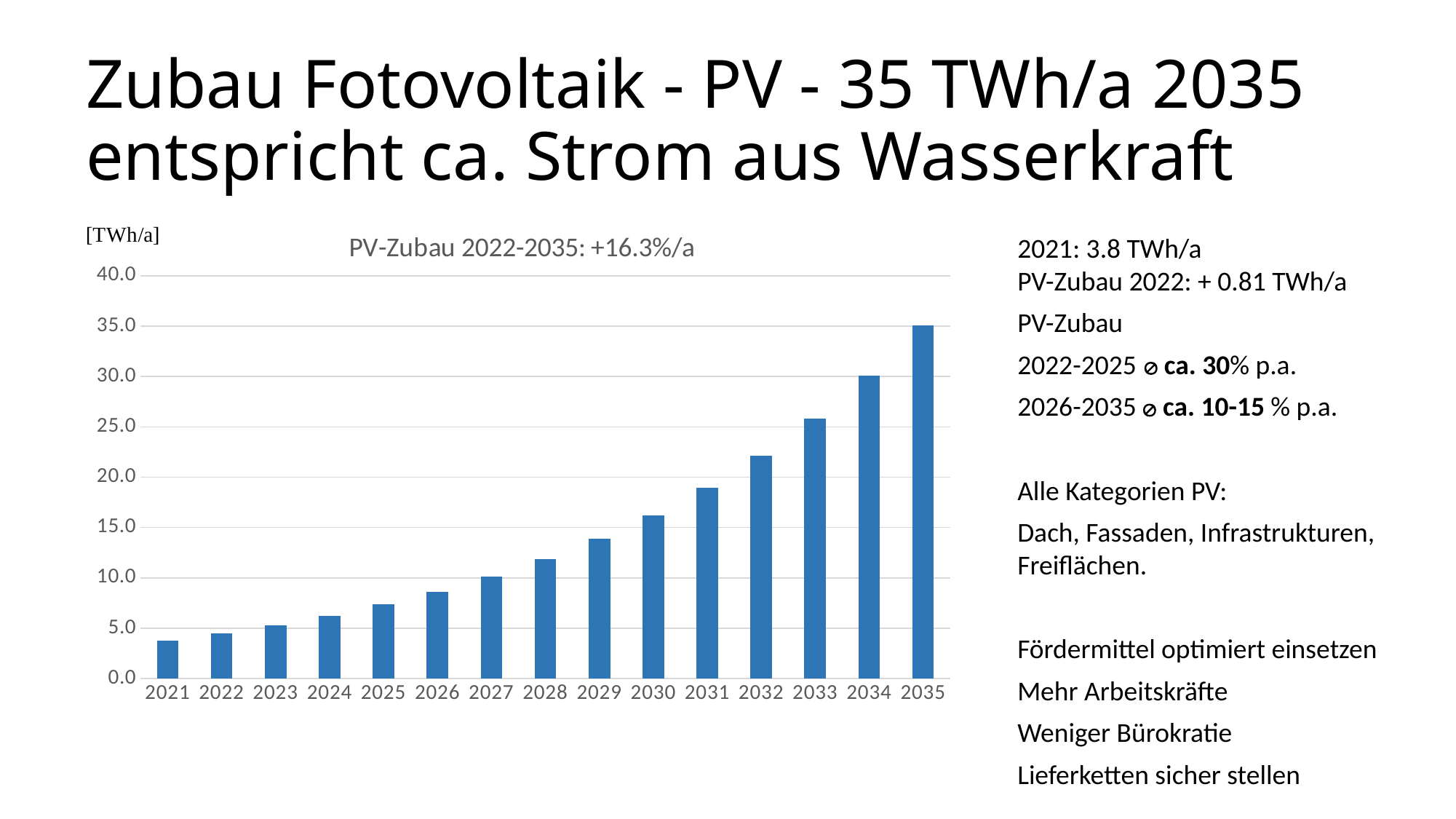
Which year has the lowest bar in the chart? 2021 Which year has the highest bar in the chart? 2035 What unit is shown on the y axis of the chart? [TWh/a] Do the values rise or fall from 2021 to 2035? rise Which is larger, the value for 2032 or the value for 2029? 2032 What kind of chart is shown on the slide? bar chart What is the value for 2035 in the chart? 35.0 Is the value for 2022 greater or less than 5.0? less How many years are plotted on the x axis of the chart? 15 Is the value for 2031 greater or less than 20.0? less Is the value for 2030 greater or less than 15.0? greater What is the title of the chart? PV-Zubau 2022-2035: +16.3%/a